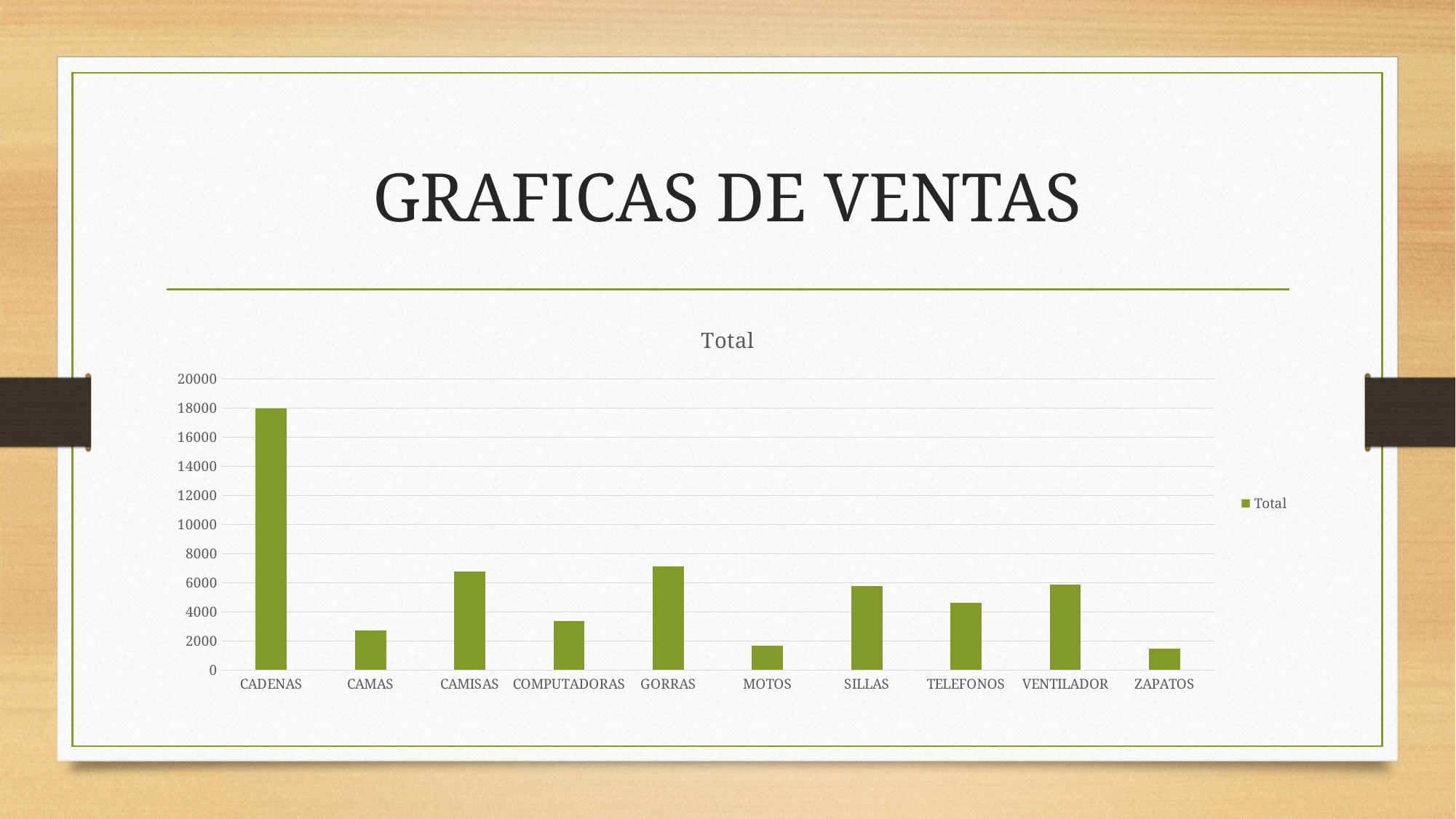
Which is larger, the value for SILLAS or the value for TELEFONOS? SILLAS How many categories are shown on the x axis of the chart? 10 What is the value for CADENAS? 18000 Is the value for CAMISAS greater or less than 6000? greater How many series does the legend list? 1 Is the value for MOTOS greater or less than 2000? less Which category has the highest value? CADENAS What type of chart is shown on the slide? bar chart What is the title of the chart? Total Is the value for COMPUTADORAS greater or less than 4000? less Which is larger, the value for CAMISAS or the value for COMPUTADORAS? CAMISAS